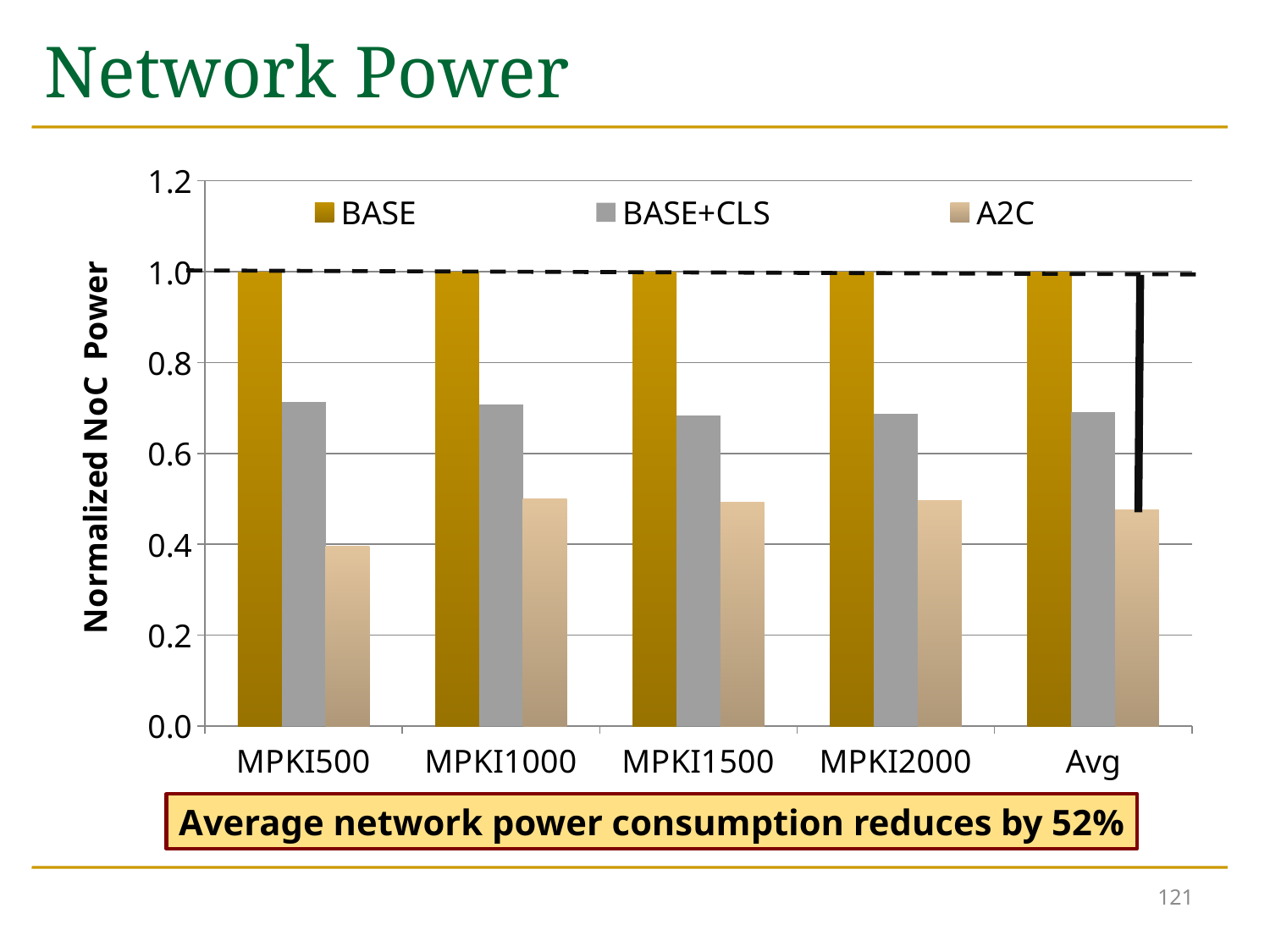
What kind of chart is shown on the slide? bar chart Which is larger at MPKI2000, BASE+CLS or A2C? BASE+CLS Is the value for A2C at Avg greater or less than 0.6? less What is the normalized NoC power for BASE at MPKI500? 1.0 How many categories are shown on the x axis? 5 For the A2C series, which category has the lowest value? MPKI500 Is the value for BASE+CLS at MPKI1000 greater or less than 0.6? greater Which series has the highest value at MPKI2000? BASE How many series does the legend list? 3 What is the normalized NoC power for BASE at Avg? 1.0 What is the label of the y axis? Normalized NoC Power Which series has the lowest value at MPKI1500? A2C